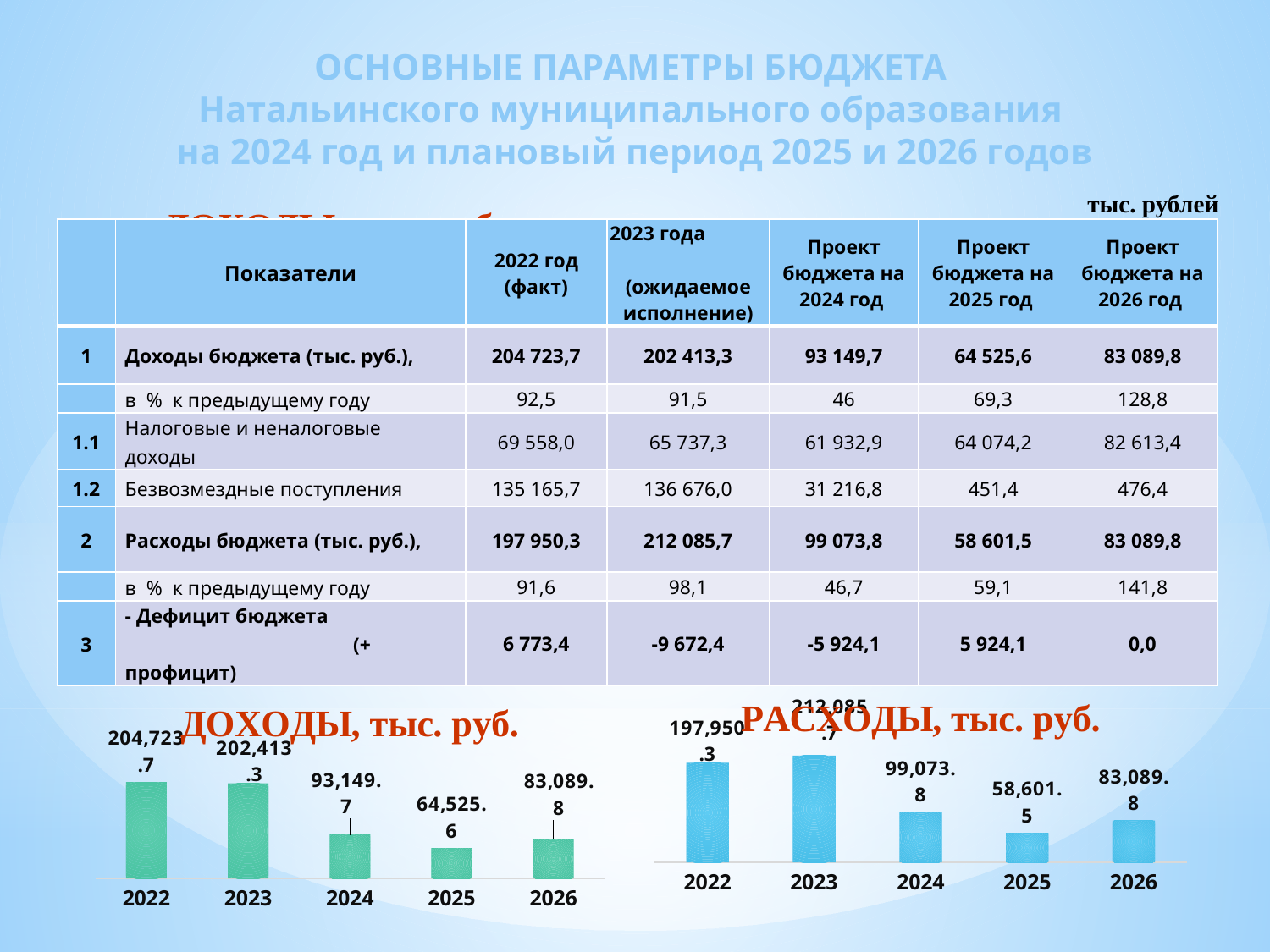
In the ДОХОДЫ, тыс. руб. chart, what is the value for 2026? 83,089.8 In the РАСХОДЫ, тыс. руб. chart, what is the value for 2023? 212,085.7 In the ДОХОДЫ, тыс. руб. chart, what is the difference between the values for 2022 and 2023? 2,310.4 In the ДОХОДЫ, тыс. руб. chart, what is the value for 2024? 93,149.7 In the РАСХОДЫ, тыс. руб. chart, which is larger: the value for 2024 or the value for 2026? 2024 In the РАСХОДЫ, тыс. руб. chart, what is the value for 2025? 58,601.5 In the ДОХОДЫ, тыс. руб. chart, which year has the highest value? 2022 In the ДОХОДЫ, тыс. руб. chart, which year has the lowest value? 2025 How many years are shown in the ДОХОДЫ, тыс. руб. chart? 5 In the РАСХОДЫ, тыс. руб. chart, which year has the lowest value? 2025 In the РАСХОДЫ, тыс. руб. chart, which year has the highest value? 2023 What type of chart is the РАСХОДЫ, тыс. руб. chart? Bar chart